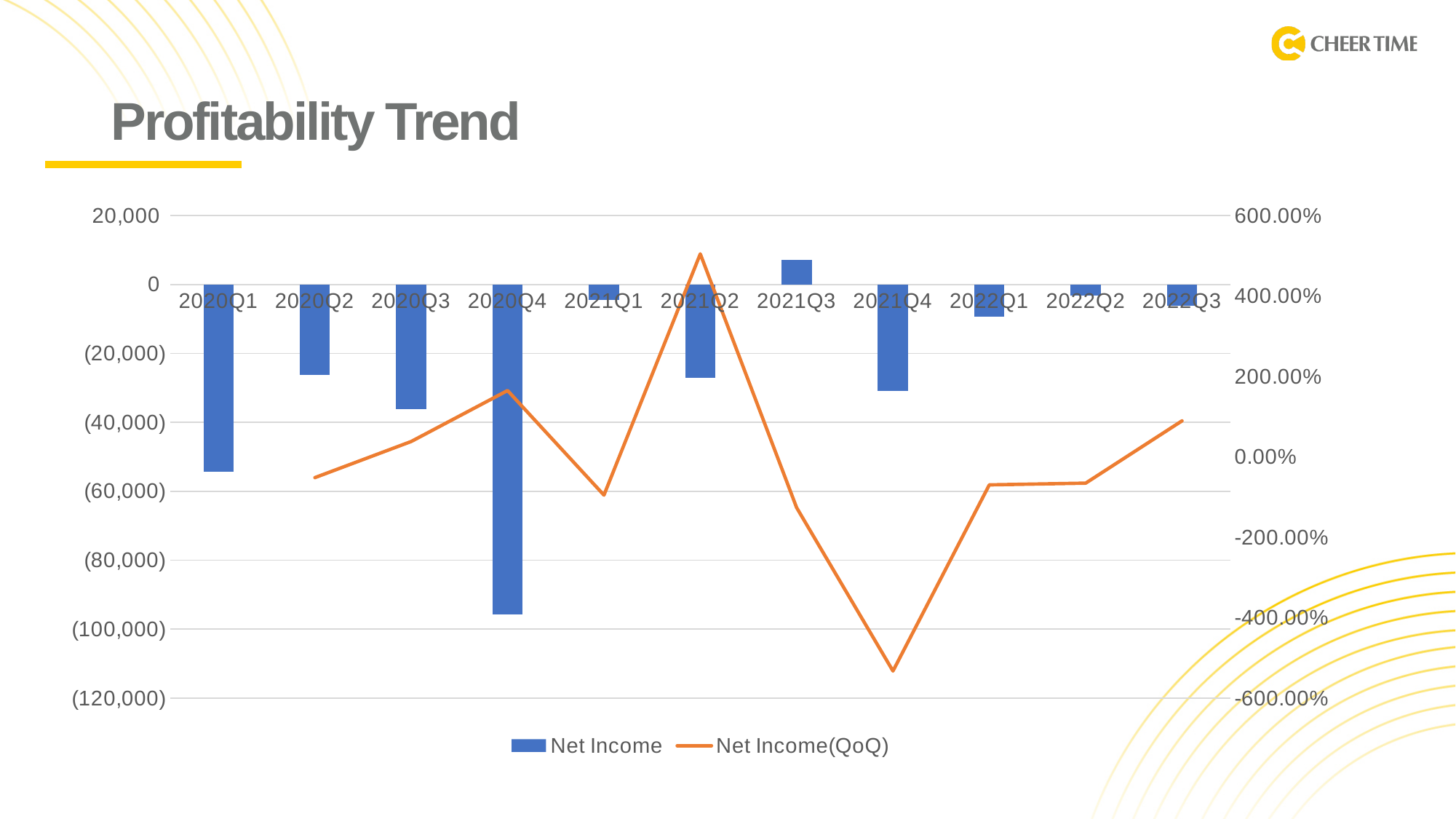
Is the Net Income for 2020Q1 greater or less than (40,000)? less In which quarter does the Net Income(QoQ) line reach its highest point? 2021Q2 In which quarter does the Net Income(QoQ) line reach its lowest point? 2021Q4 Which quarter has the lowest Net Income bar? 2020Q4 What is the title of the chart on the slide? Profitability Trend Is the Net Income(QoQ) value for 2021Q2 greater or less than 400.00%? greater Which quarter has the highest Net Income bar? 2021Q3 How many series does the legend list? 2 Is the Net Income for 2020Q4 greater or less than (80,000)? less Which quarter has the lower Net Income, 2020Q2 or 2020Q3? 2020Q3 How many quarters are shown on the x axis of the chart? 11 What kind of chart is shown on the slide? A combined bar and line chart